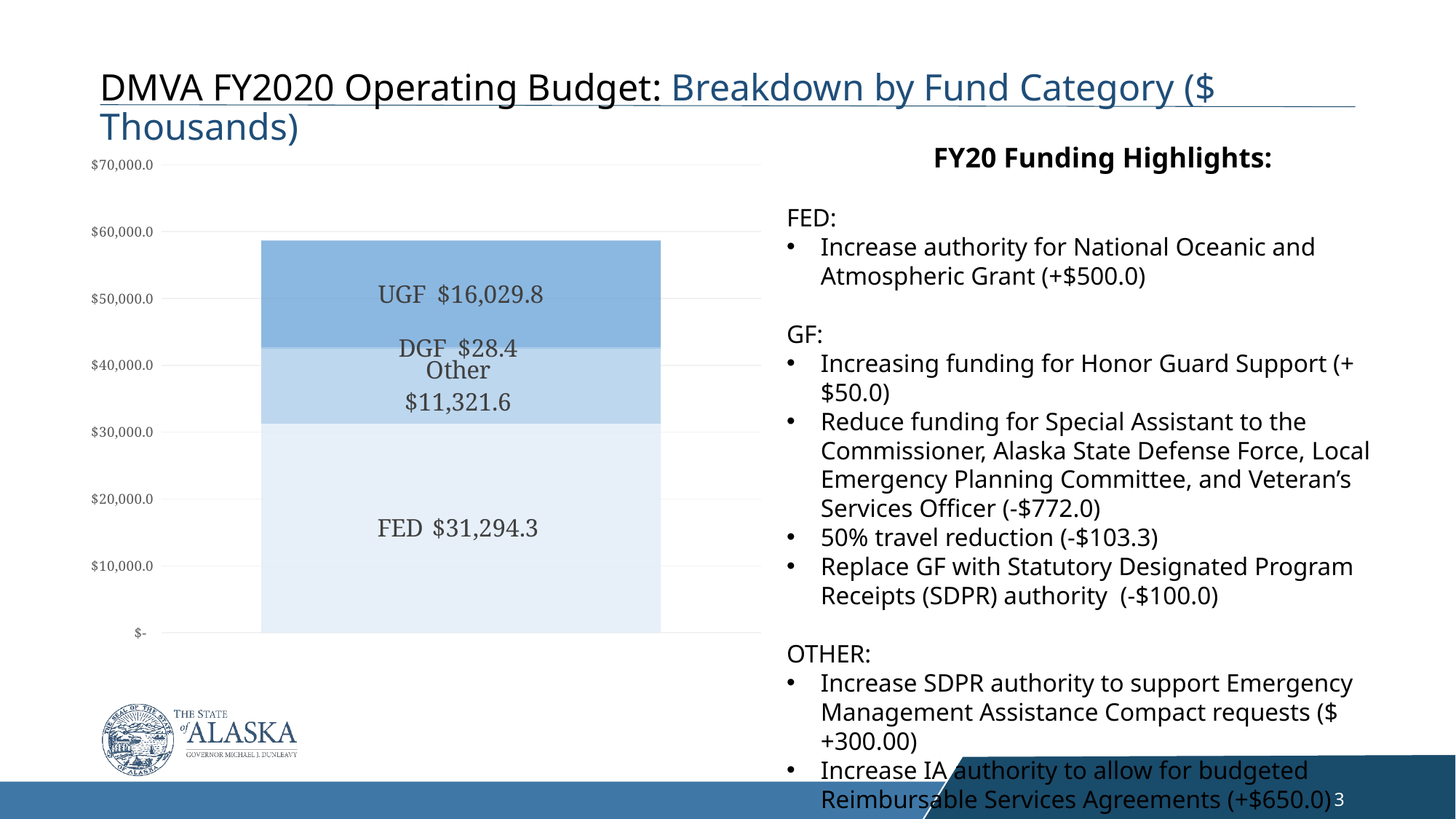
Which is larger, the UGF value or the Other value? UGF What is the value of the FED segment in the stacked bar? $31,294.3 What is the value of the Other segment in the stacked bar? $11,321.6 What is the value of the DGF segment in the stacked bar? $28.4 How many fund category segments make up the stacked bar? 4 Which fund category has the smallest value in the stacked bar? DGF What is the total of the stacked bar across all four fund categories? $58,674.1 What is the difference between the FED and UGF values? $15,264.5 What kind of chart is shown on the slide? Stacked bar chart Which fund category has the largest value in the stacked bar? FED What is the value of the UGF segment in the stacked bar? $16,029.8 What is the difference between the UGF and Other values? $4,708.2